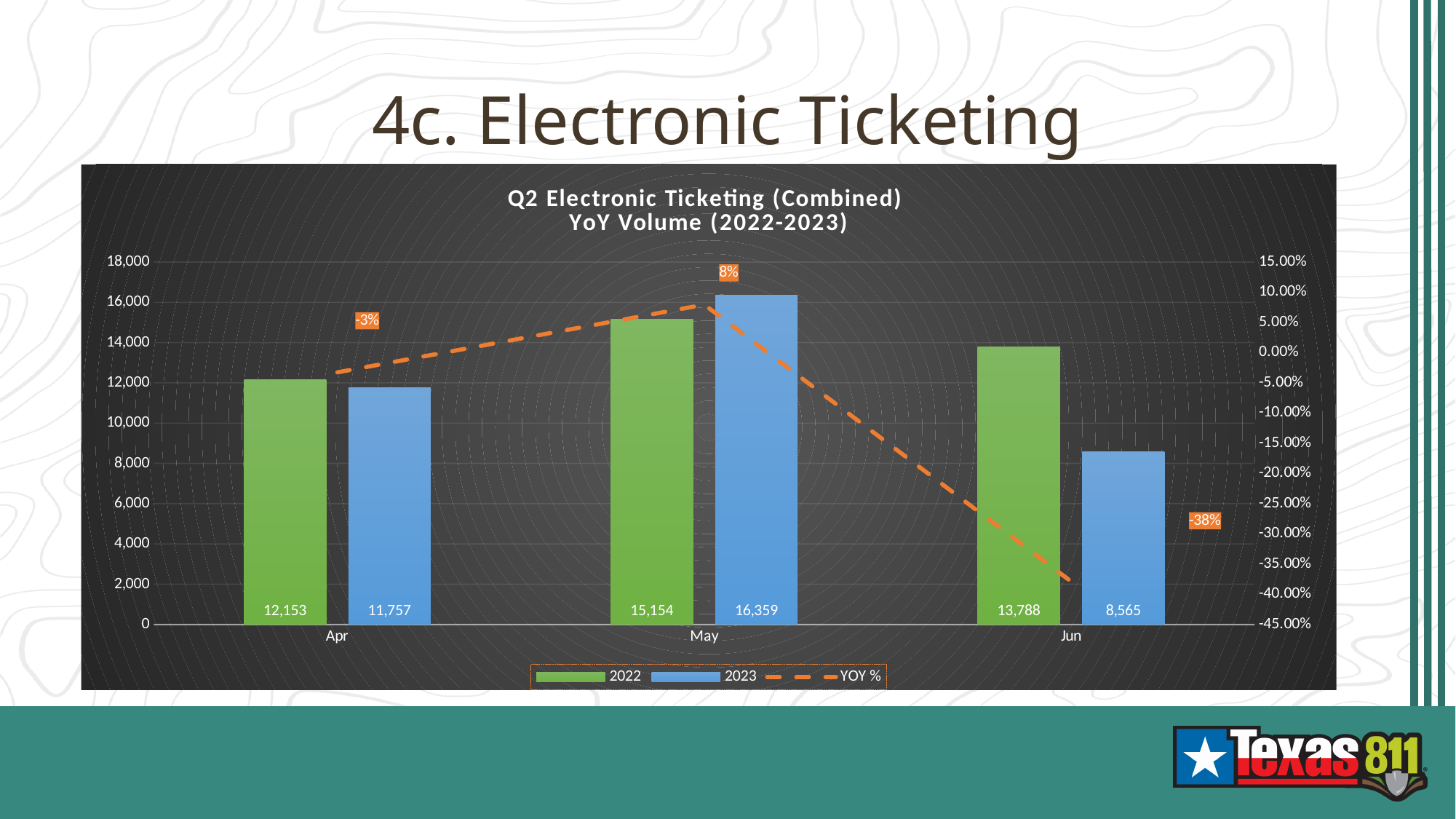
Which is larger for May, the 2022 value or the 2023 value? 2023 Which month has the highest 2023 value? May Does the YOY % line rise or fall from May to Jun? fall What is the title of the chart? Q2 Electronic Ticketing (Combined) YoY Volume (2022-2023) How many months are shown on the x axis? 3 What is the 2023 value for Jun? 8,565 What is the difference between the 2022 and 2023 values for Jun? 5,223 What is the YOY % value for Jun? -38% What is the 2022 value for Apr? 12,153 Which month has the lowest 2023 value? Jun What is the 2023 value for May? 16,359 How many series does the legend list? 3